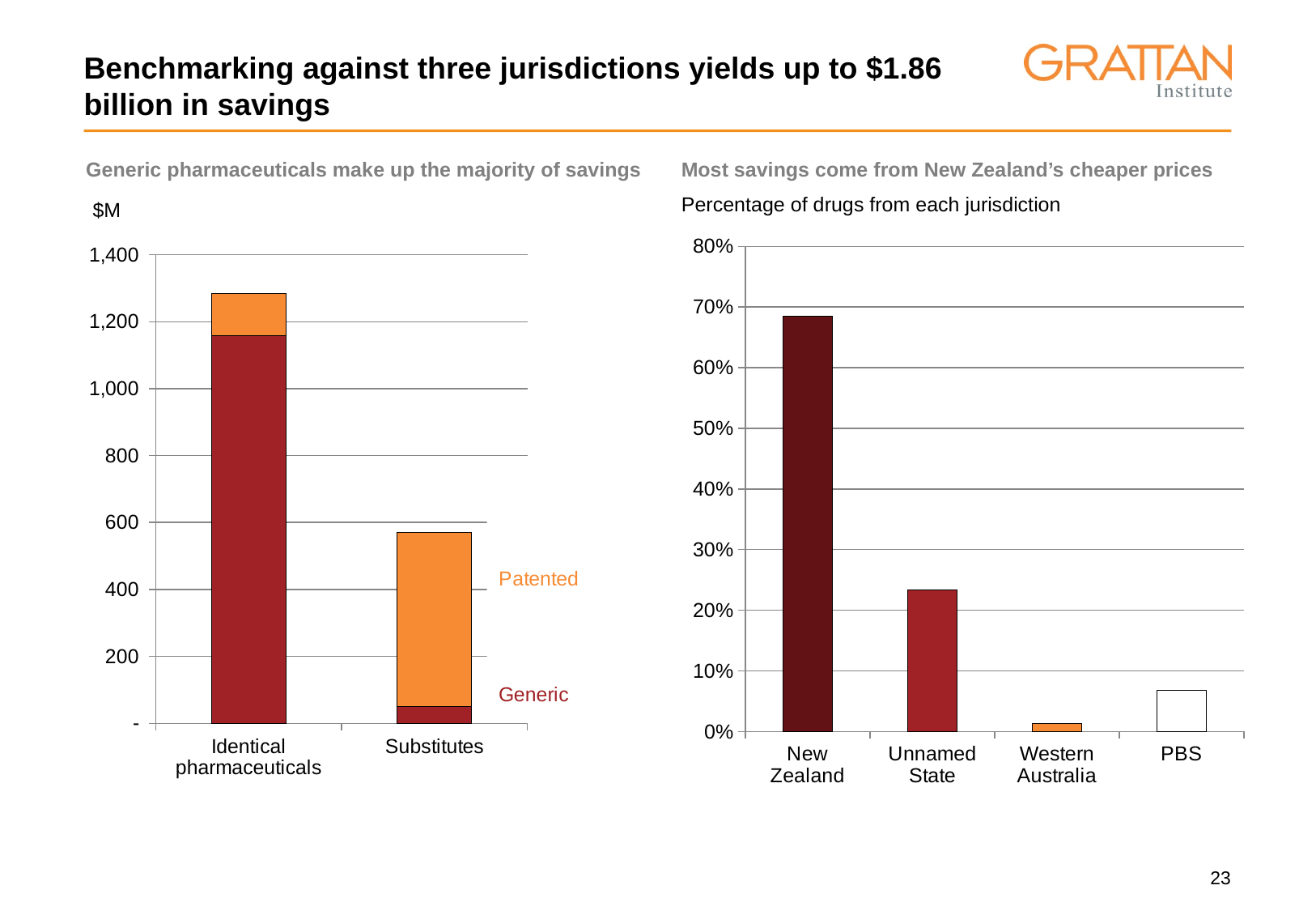
On the left chart, is the total value for Identical pharmaceuticals greater or less than 1,200? greater On the left chart, which category has the higher total savings? Identical pharmaceuticals On the right chart, which jurisdiction has the highest percentage of drugs? New Zealand On the right chart, which jurisdiction has the lowest percentage of drugs? Western Australia On the right chart, how many jurisdictions are shown on the x axis? 4 On the left chart, how many categories are shown on the x axis? 2 On the right chart, is the value for Unnamed State greater or less than 20%? greater On the left chart, how many series are labelled? 2 On the left chart, what kind of chart is used to show the savings? Stacked bar chart On the left chart, is the total value for Substitutes greater or less than 600? less On the left chart, which series makes up most of the Substitutes bar, Patented or Generic? Patented On the left chart, what unit is shown on the y axis? $M